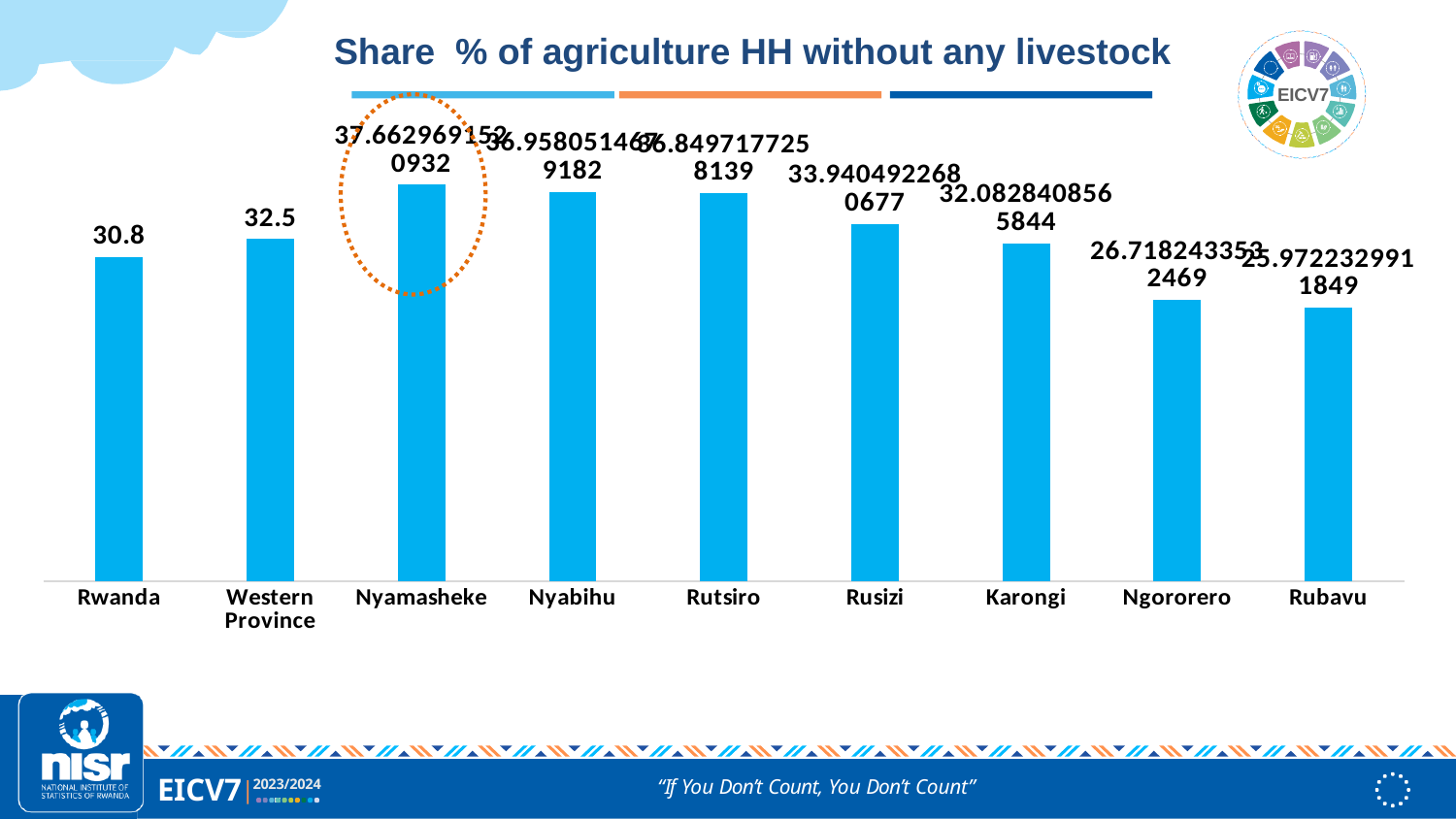
What is the value shown for Rusizi? 33.9404922680677 What kind of chart is shown on the slide? Bar chart Which category has the highest share of agriculture households without any livestock? Nyamasheke Which is larger, the value for Rusizi or the value for Karongi? Rusizi Which is larger, the value for Rwanda or the value for Western Province? Western Province What is the value for Rwanda? 30.8 How many categories are shown on the x axis? 9 What is the title of the chart? Share % of agriculture HH without any livestock Which category has the lowest share of agriculture households without any livestock? Rubavu What is the value shown for Karongi? 32.0828408565844 What is the difference between the values for Western Province and Rwanda? 1.7 What is the value for Western Province? 32.5